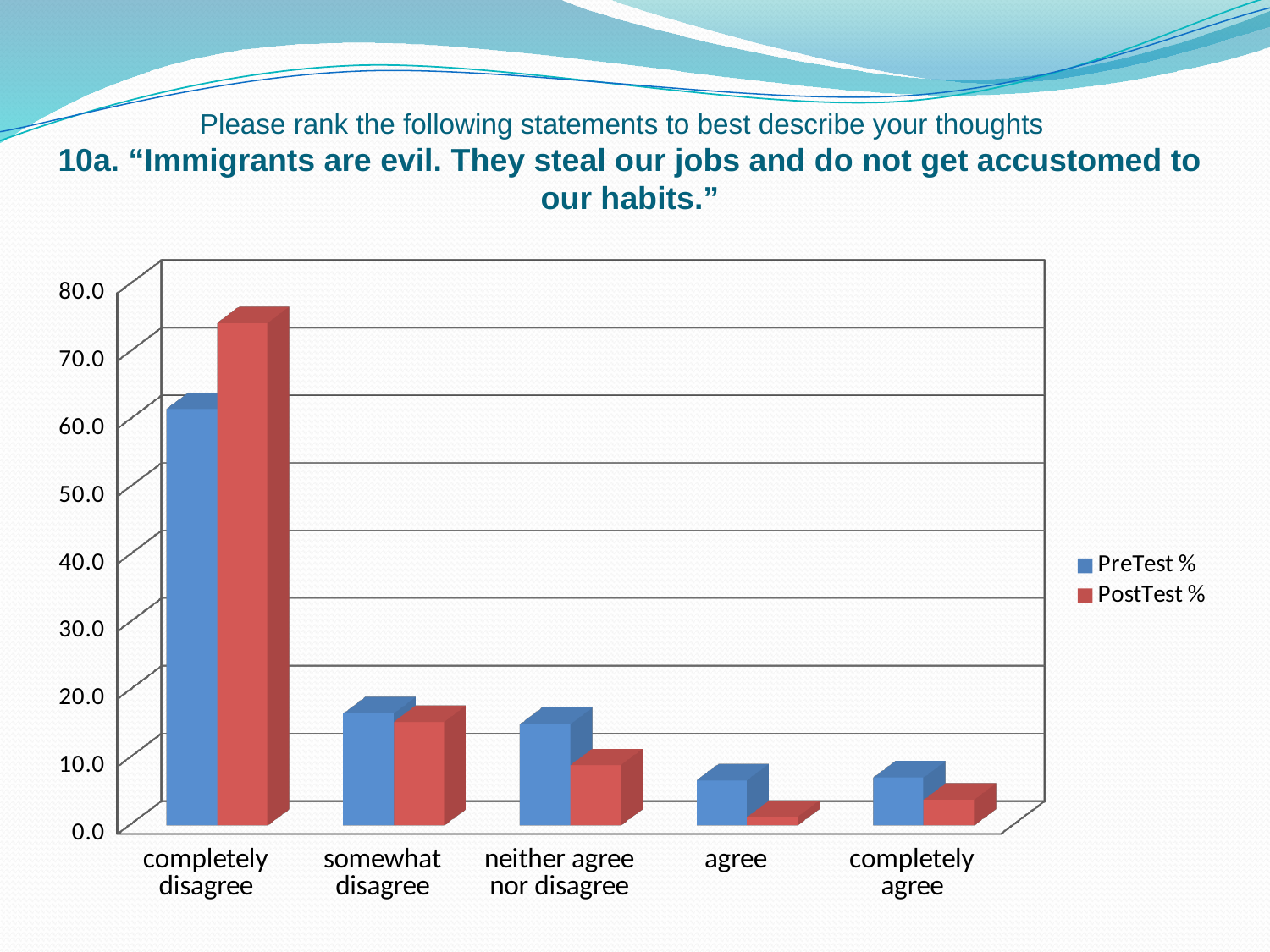
Which category has the lowest PostTest % value? agree For 'completely agree', which is larger: the PreTest % or the PostTest % value? PreTest % Is the PreTest % value for 'completely disagree' greater or less than 50.0? greater What kind of chart is shown on the slide? bar chart Which category has the highest PreTest % value? completely disagree How many categories are shown on the x axis of the chart? 5 How many series does the chart's legend list? 2 Is the PostTest % value for 'completely disagree' greater or less than 60.0? greater Is the PostTest % value for 'agree' greater or less than 10.0? less What are the two series named in the legend? PreTest % and PostTest % For 'completely disagree', which is larger: the PreTest % or the PostTest % value? PostTest % For 'neither agree nor disagree', which is larger: the PreTest % or the PostTest % value? PreTest %